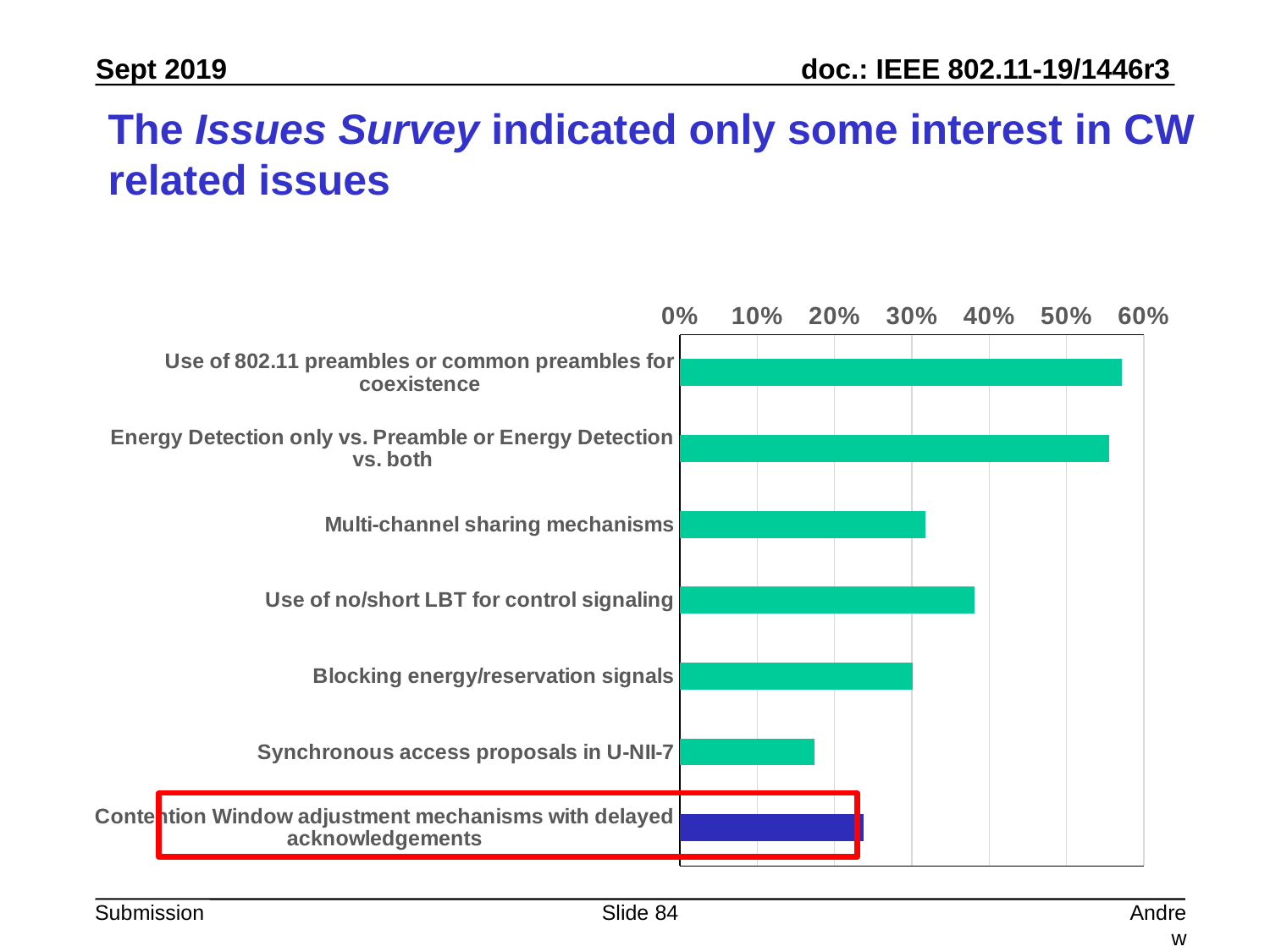
Is the value for 'Use of no/short LBT for control signaling' greater or less than 30%? greater Which has the larger value: 'Synchronous access proposals in U-NII-7' or 'Contention Window adjustment mechanisms with delayed acknowledgements'? Contention Window adjustment mechanisms with delayed acknowledgements What kind of chart is shown on the slide? Bar chart Is the value for 'Use of 802.11 preambles or common preambles for coexistence' greater or less than 50%? greater Is the value for 'Multi-channel sharing mechanisms' greater or less than 40%? less How many categories (bars) does the chart show? 7 Which category has the lowest value in the chart? Synchronous access proposals in U-NII-7 What is the highest value shown on the chart's percentage axis? 60% Which category's bar is drawn in a different colour (dark blue) and outlined with a red box? Contention Window adjustment mechanisms with delayed acknowledgements Which has the larger value: 'Use of no/short LBT for control signaling' or 'Multi-channel sharing mechanisms'? Use of no/short LBT for control signaling